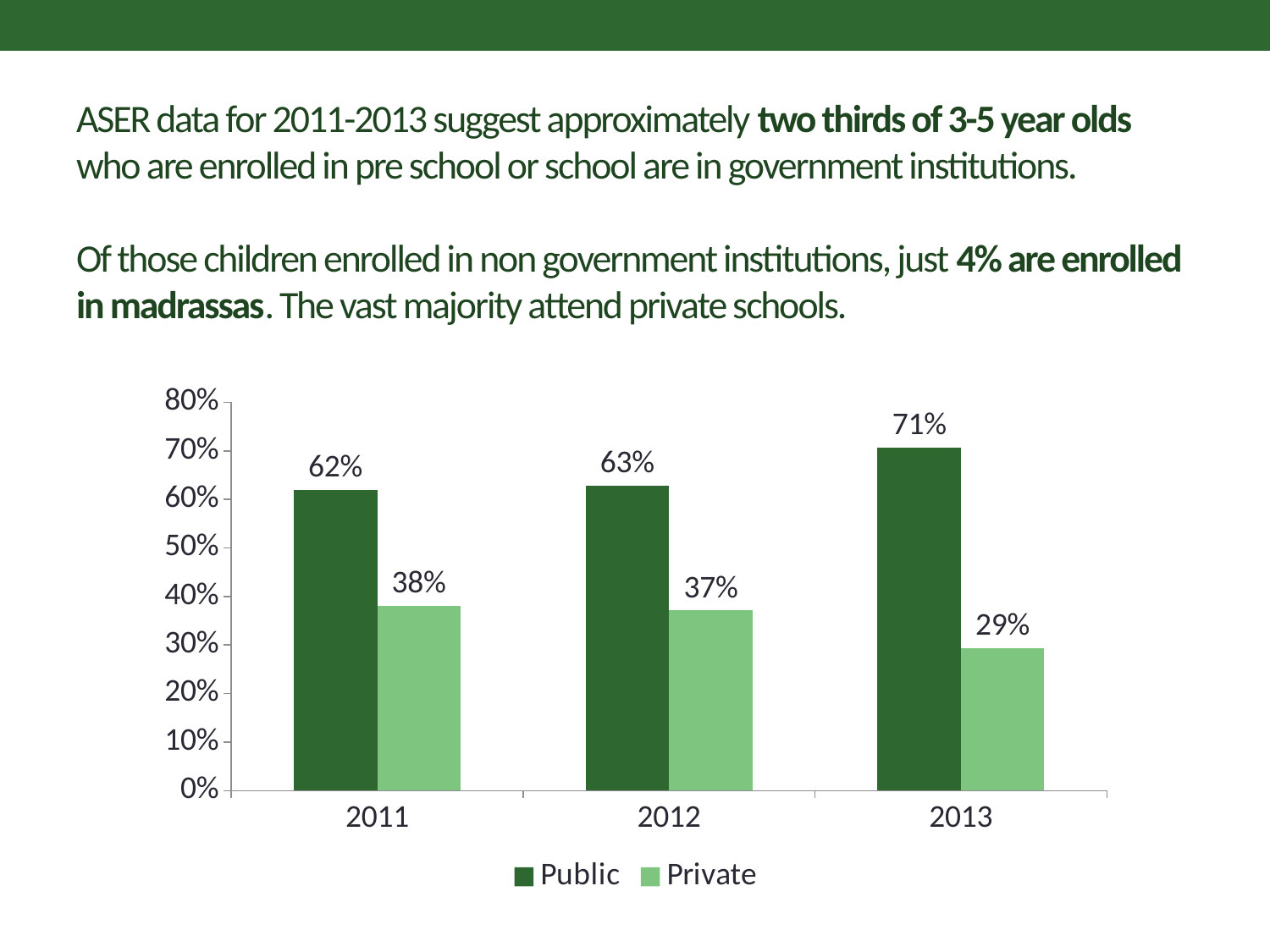
What is the difference between the Public values for 2011 and 2013? 9% In which year is the Private value lowest? 2013 What kind of chart is shown on the slide? Bar chart How many series does the legend list? 2 How many years are shown on the x axis? 3 What is the Private value for 2012? 37% Does the Private value rise or fall from 2011 to 2013? Fall What is the Private value for 2011? 38% In which year is the Public value highest? 2013 What is the Public value for 2013? 71% Which is larger in 2012, the Public value or the Private value? Public What is the difference between the Public and Private values in 2013? 42%